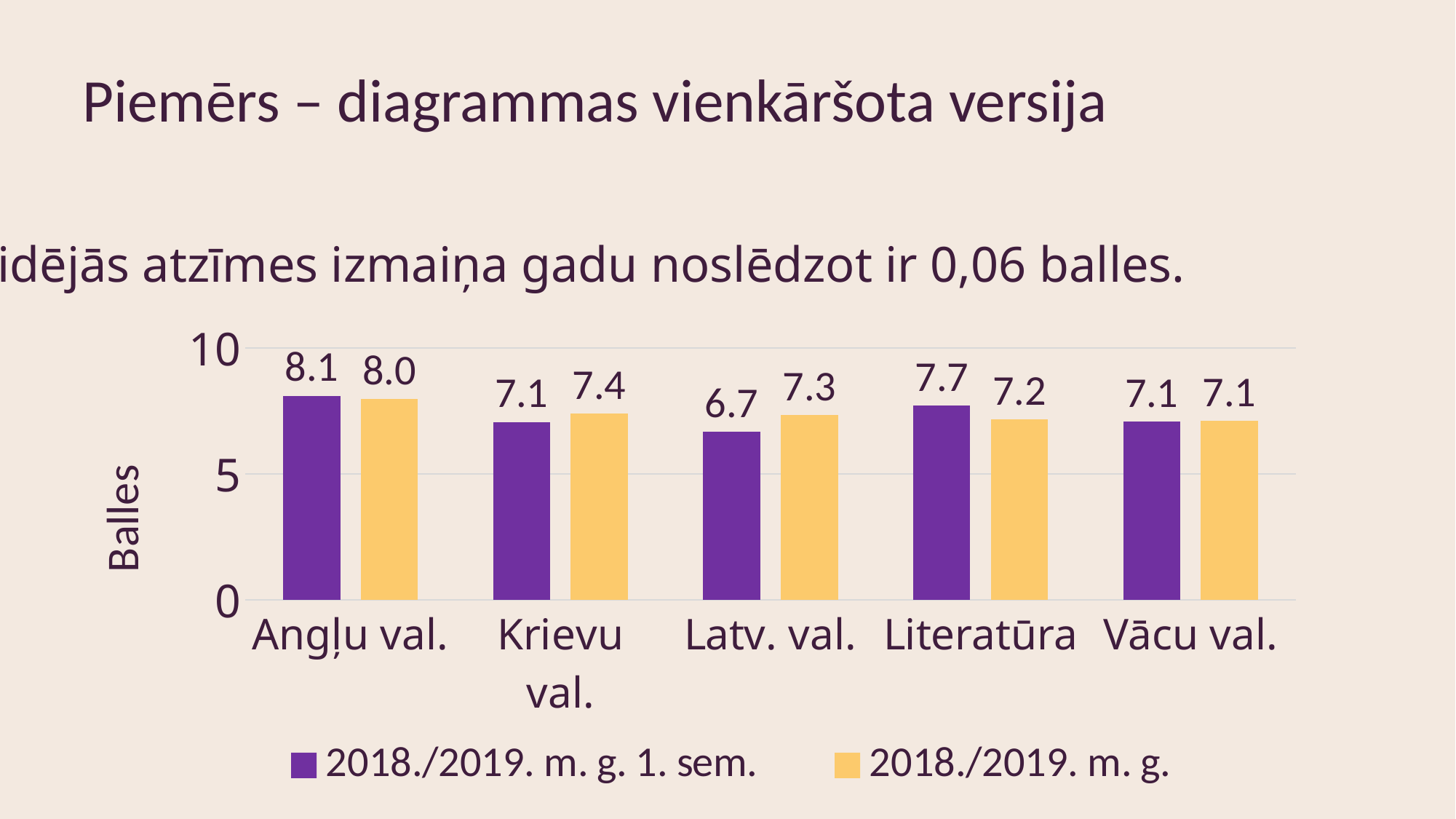
What is the label of the vertical axis? Balles Which category has the highest value in the 2018./2019. m. g. 1. sem. series? Angļu val. What is the value for Literatūra in the 2018./2019. m. g. 1. sem. series? 7.7 What is the value for Latv. val. in the 2018./2019. m. g. series? 7.3 What is the difference between the 2018./2019. m. g. and 2018./2019. m. g. 1. sem. values for Latv. val.? 0.6 What is the value for Angļu val. in the 2018./2019. m. g. 1. sem. series? 8.1 Is the value for Vācu val. in the 2018./2019. m. g. series greater or less than 5? greater What kind of chart is shown on the slide? bar chart How many categories are shown on the x axis? 5 For Krievu val., which series has the larger value: 2018./2019. m. g. 1. sem. or 2018./2019. m. g.? 2018./2019. m. g. How many series does the legend list? 2 Which category has the lowest value in the 2018./2019. m. g. 1. sem. series? Latv. val.